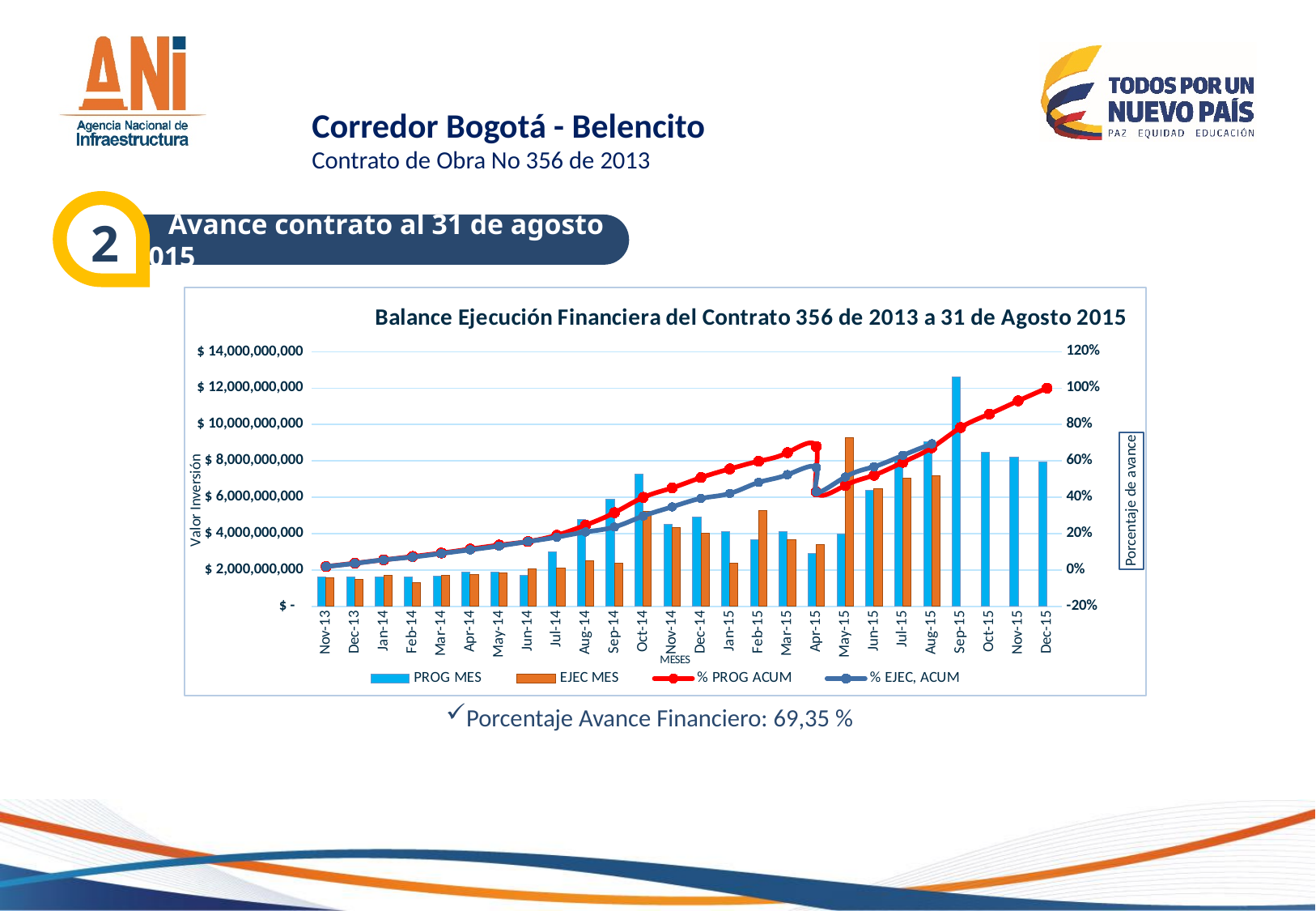
In which month is the PROG MES bar the highest? Sep-15 Is the EJEC MES value for May-15 greater or less than $8,000,000,000? greater For Feb-15, which is larger: the PROG MES bar or the EJEC MES bar? EJEC MES How many months are shown along the x axis of the chart? 26 Which series is drawn as the red line with circular markers? % PROG ACUM In which month is the EJEC MES bar the highest? May-15 Does the % PROG ACUM line generally rise or fall from Nov-13 to Dec-15? Rise What kind of chart is shown on the slide? A combined bar and line chart How many series does the chart legend list? 4 Is the PROG MES value for Sep-15 greater or less than $12,000,000,000? greater For Oct-14, which is larger: the PROG MES bar or the EJEC MES bar? PROG MES What is the title of the chart? Balance Ejecución Financiera del Contrato 356 de 2013 a 31 de Agosto 2015